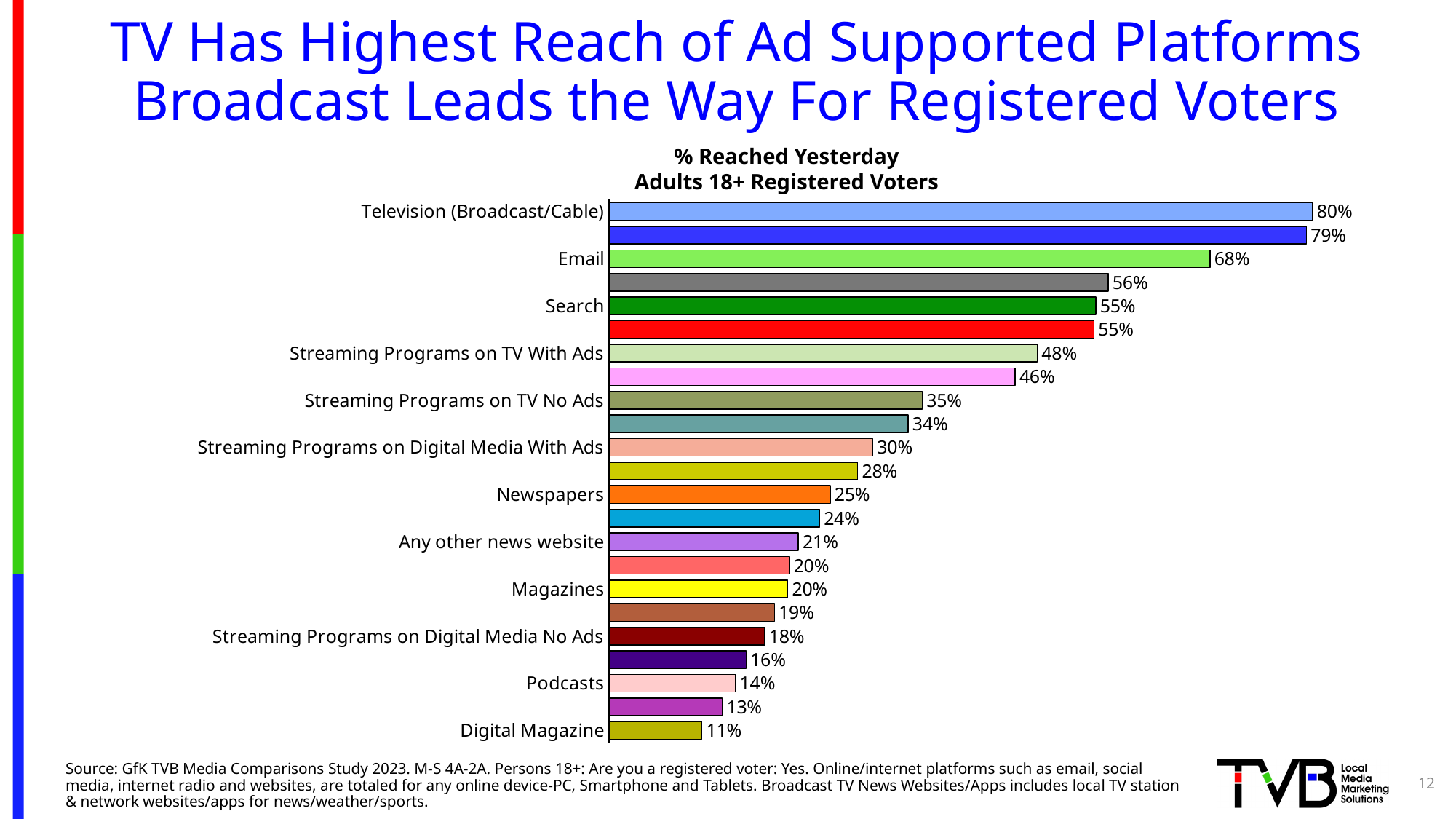
What kind of chart is shown on the slide? Bar chart What is the value for Podcasts? 14% Which labeled category has the highest value? Television (Broadcast/Cable) What is the value for Email? 68% What is the value for Streaming Programs on TV With Ads? 48% What is the value for Television (Broadcast/Cable)? 80% What is the difference between the values for Streaming Programs on TV No Ads and Streaming Programs on Digital Media No Ads? 17 percentage points Which labeled category has the lowest value? Digital Magazine What is the difference between the values for Television (Broadcast/Cable) and Email? 12 percentage points What is the title of the chart? % Reached Yesterday Adults 18+ Registered Voters Which is larger, the value for Search or the value for Newspapers? Search How many bars are plotted in the chart? 23